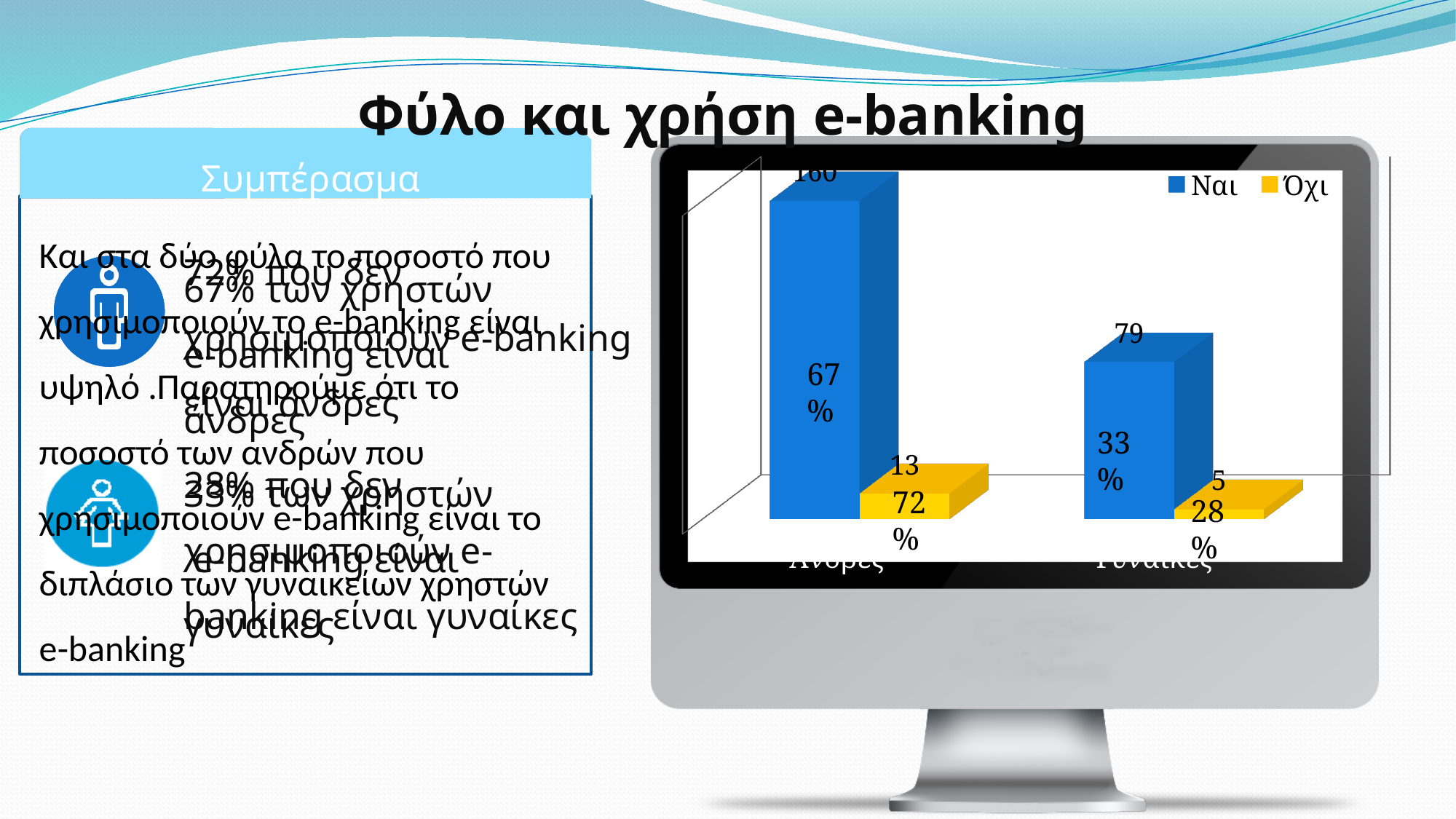
How many series does the chart legend list? 2 What are the two entries in the chart legend? Ναι and Όχι Which category has the higher Ναι value, Άνδρες or Γυναίκες? Άνδρες What is the value of the Όχι bar for Άνδρες? 13 Which bar in the chart is the shortest? Όχι for Γυναίκες What kind of chart is shown on the slide? bar chart For Γυναίκες, which series has the larger value, Ναι or Όχι? Ναι What colour represents the Ναι series in the chart? blue How many categories are shown on the x axis of the chart? 2 What is the value of the Ναι bar for Γυναίκες? 79 Which category has the larger Όχι value, Άνδρες or Γυναίκες? Άνδρες Which bar in the chart is the tallest? Ναι for Άνδρες